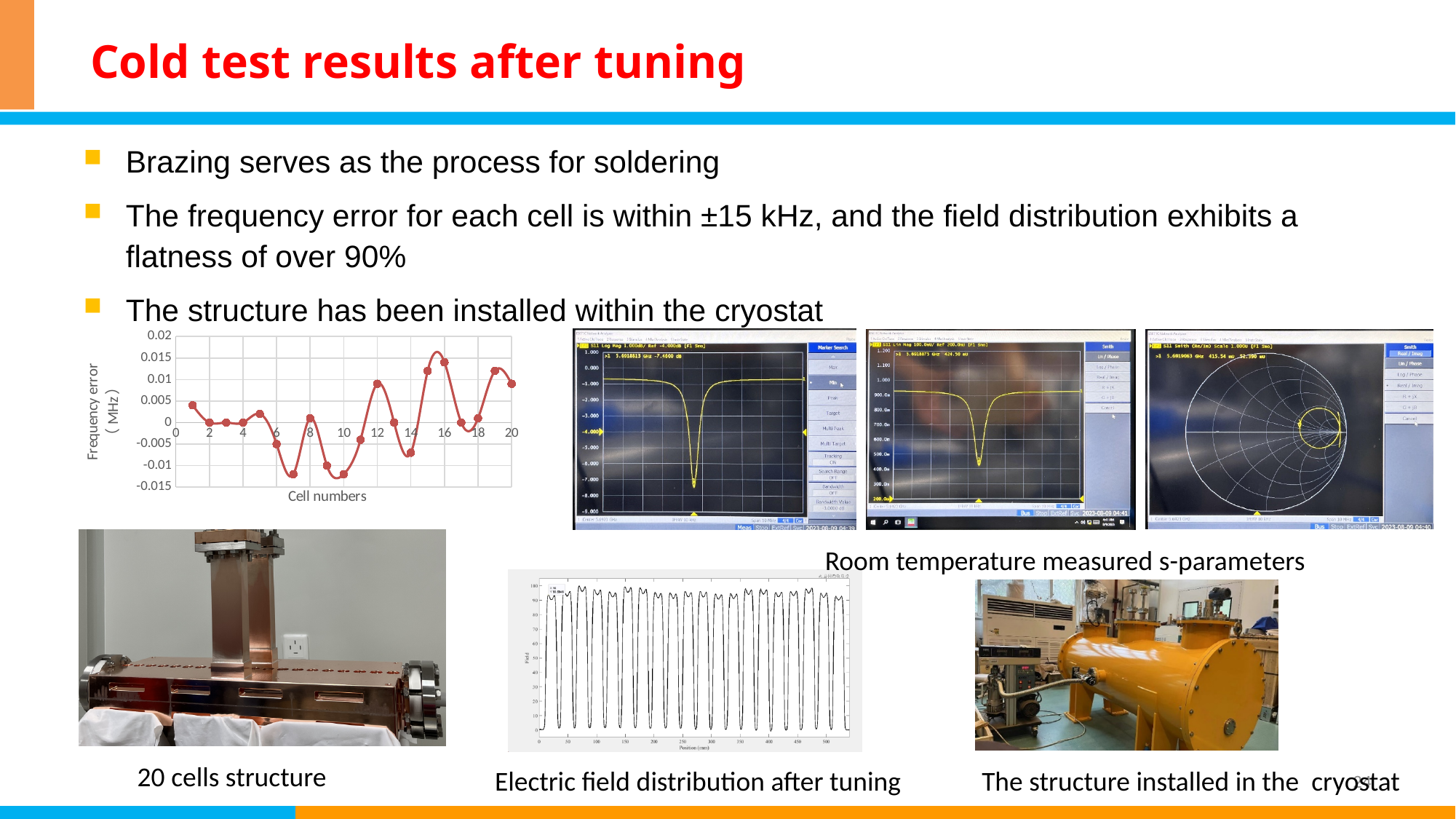
In the frequency error chart, what is the title of the vertical axis? Frequency error (MHz) In the frequency error chart, which has the larger frequency error, cell 12 or cell 14? cell 12 In the frequency error chart, is the value for cell 1 greater or less than 0? greater In the frequency error chart, what is the title of the horizontal axis? Cell numbers In the frequency error chart, is the value for cell 12 greater or less than 0.005? greater In the frequency error chart, is the value for cell 7 greater or less than -0.01? less In the frequency error chart, how many cells (data points) are plotted? 20 In the frequency error chart, which has the larger frequency error, cell 1 or cell 7? cell 1 What kind of chart is the frequency error chart at the top left of the slide? line chart